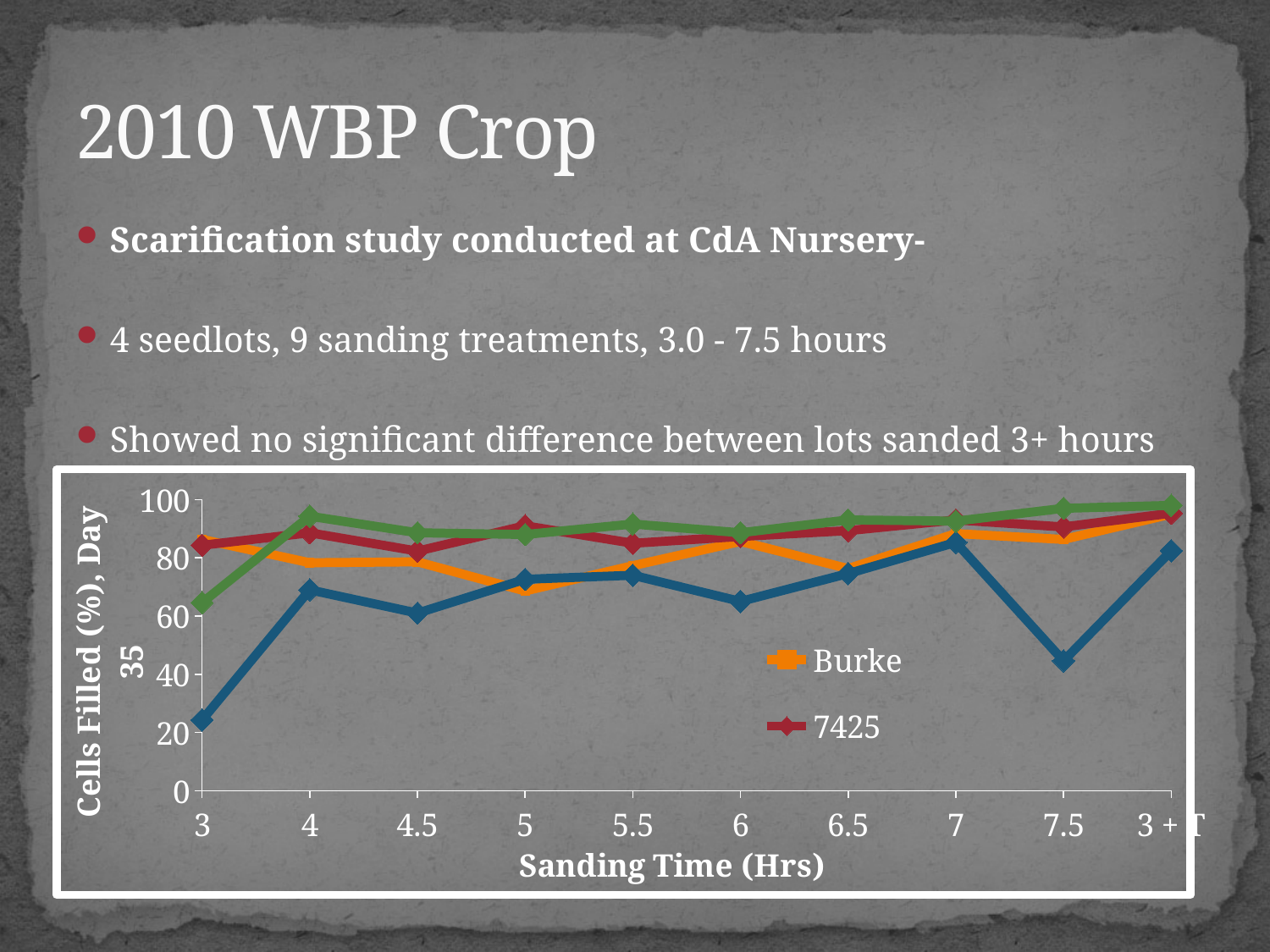
How many sanding time categories are shown along the x axis of the chart? 10 At a sanding time of 5 hours, which series has the larger value, Burke or 7425? 7425 What is the title of the chart's x axis? Sanding Time (Hrs) Is the value for Burke at a sanding time of 7 hours greater or less than 60? greater What is the title of the chart's y axis? Cells Filled (%), Day 35 Is the value for 7425 at a sanding time of 5 hours greater or less than 80? greater What kind of chart is shown on the slide? line chart Is the value for 7425 at a sanding time of 4.5 hours greater or less than 60? greater How many series does the chart's legend list? 2